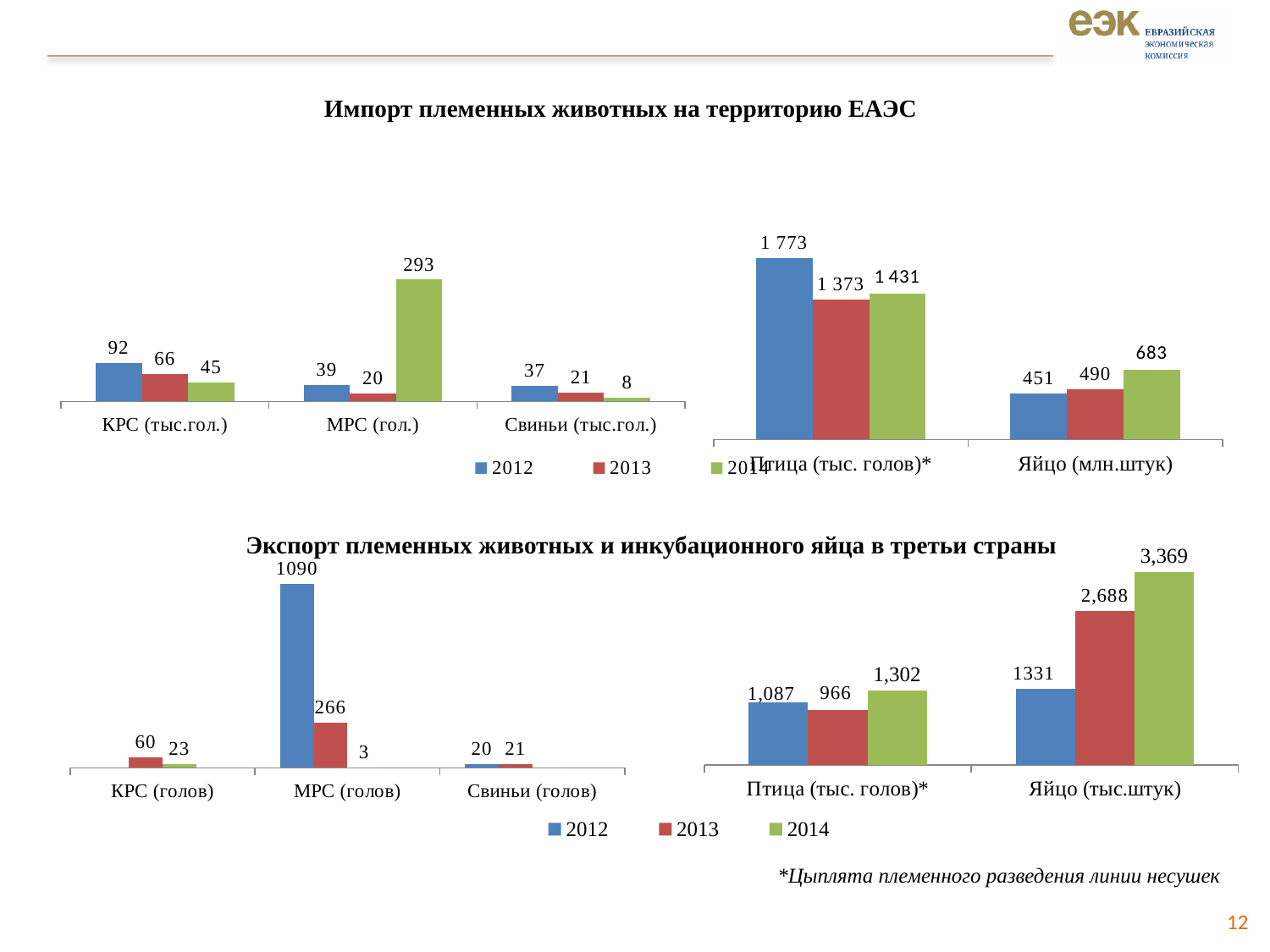
In the top-right import chart, what is the difference between the 2014 and 2012 values for Яйцо (млн.штук)? 232 In the top-right import chart, what is the 2012 value for Птица (тыс. голов)*? 1 773 In the top-left import chart, what is the 2012 value for КРС (тыс.гол.)? 92 In the bottom-left export chart, what is the 2012 value for МРС (голов)? 1090 In the bottom-right export chart, is the 2013 value for Птица (тыс. голов)* larger or smaller than the 2014 value? smaller In the top-right import chart, which year has the highest value for Птица (тыс. голов)*? 2012 How many series does the legend list for the charts on the slide? 3 In the bottom-right export chart, do the values for Яйцо (тыс.штук) rise or fall from 2012 to 2014? rise In the bottom-right export chart, what is the 2014 value for Яйцо (тыс.штук)? 3,369 In the bottom-left export chart, what is the 2013 value for КРС (голов)? 60 In the top-left import chart, which year has the lowest value for Свиньи (тыс.гол.)? 2014 In the top-left import chart, what is the 2014 value for МРС (гол.)? 293